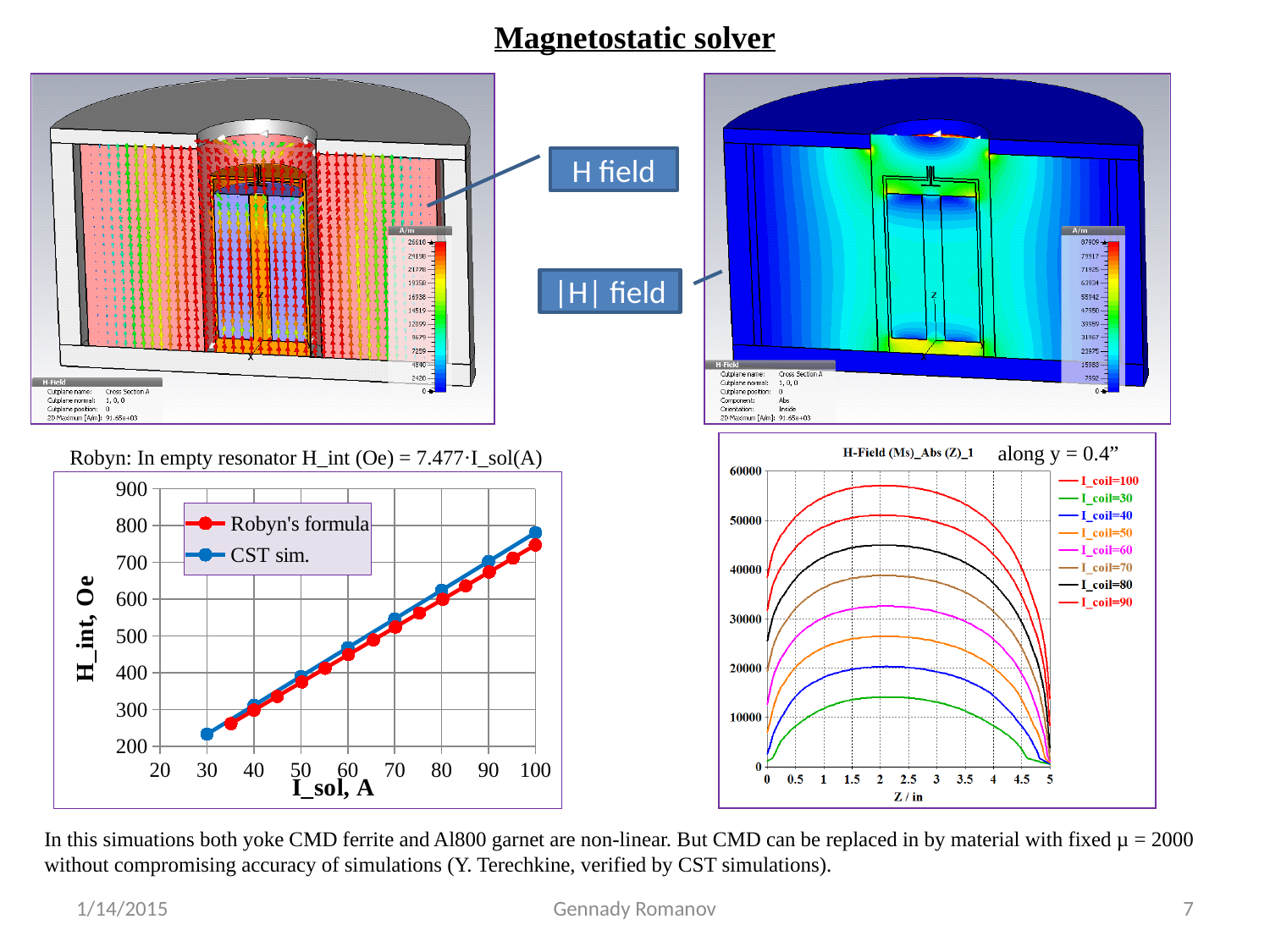
In the bottom-right chart (H-Field (Ms)_Abs (Z)_1), which series reaches the highest values? I_coil=100 In the bottom-right chart (H-Field (Ms)_Abs (Z)_1), is the peak value of the I_coil=50 curve greater or less than 30000? less In the bottom-left chart (H_int vs I_sol), do the values rise or fall as I_sol increases? rise How many series does the legend of the bottom-left chart (H_int vs I_sol) list? 2 What kind of chart is the bottom-left chart with axes I_sol, A and H_int, Oe? line chart In the bottom-left chart (H_int vs I_sol), which series has the higher value at I_sol = 100 A, Robyn's formula or CST sim.? CST sim. In the bottom-right chart (H-Field (Ms)_Abs (Z)_1), which series has the lowest values? I_coil=30 What is the title of the bottom-right chart? H-Field (Ms)_Abs (Z)_1 In the bottom-right chart (H-Field (Ms)_Abs (Z)_1), is the peak value of the I_coil=100 curve greater or less than 50000? greater In the bottom-left chart (H_int vs I_sol), is the CST sim. value at I_sol = 100 A greater or less than 800 Oe? less How many series does the legend of the bottom-right chart (H-Field (Ms)_Abs (Z)_1) list? 8